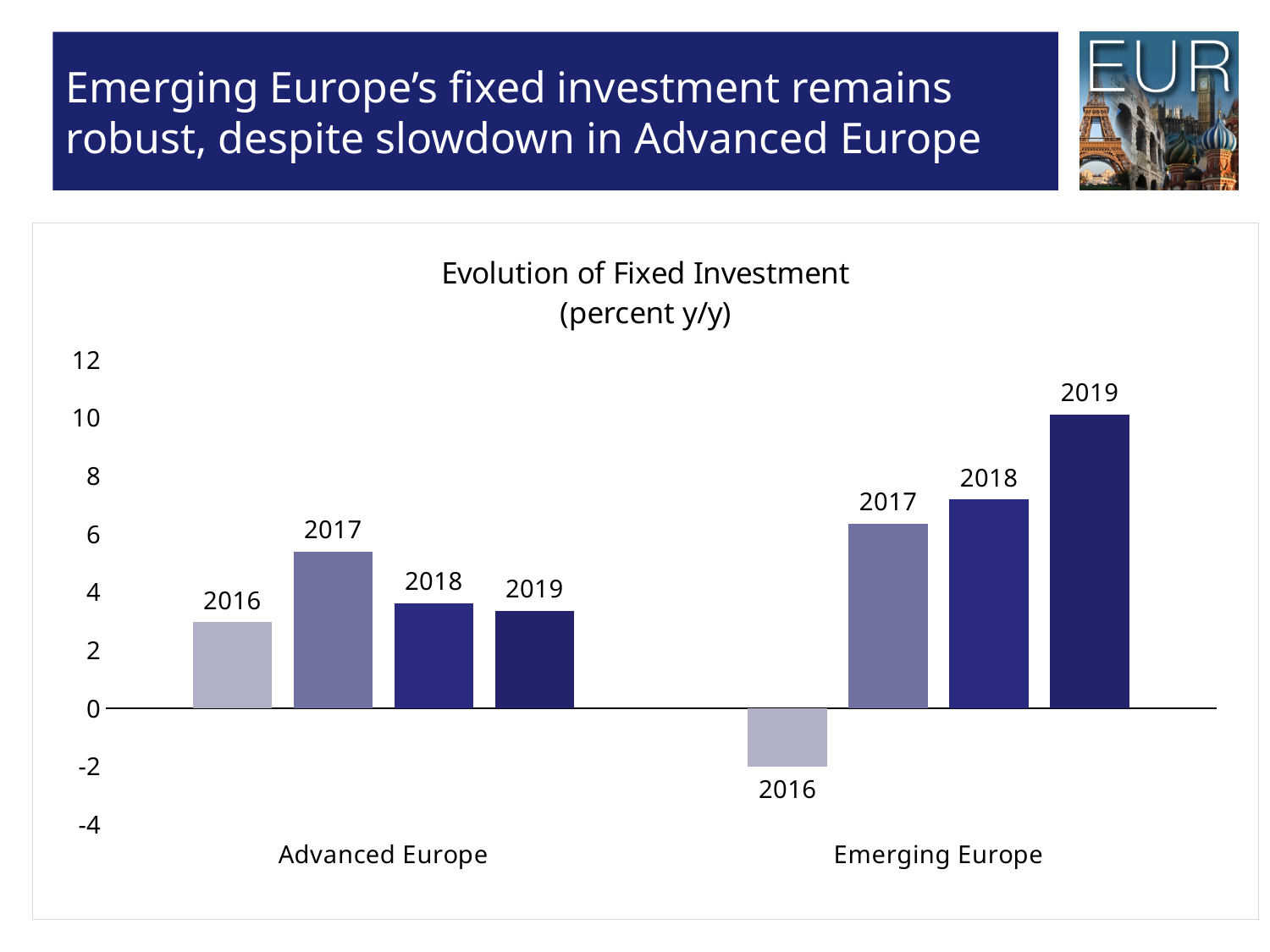
Which is larger in 2019, the value for Advanced Europe or for Emerging Europe? Emerging Europe Is the value for Emerging Europe in 2016 greater or less than 0? less Is the value for Advanced Europe in 2017 greater or less than 4? greater How many years are plotted for each region in the chart? 4 Which year has the highest bar for Emerging Europe? 2019 Is the value for Emerging Europe in 2019 greater or less than 8? greater Do the values for Emerging Europe rise or fall from 2016 to 2019? rise What kind of chart is shown on the slide? bar chart How many bars are plotted in total across both regions? 8 Which year has the lowest bar for Emerging Europe? 2016 What is the title of the chart? Evolution of Fixed Investment (percent y/y) Which year has the highest bar for Advanced Europe? 2017